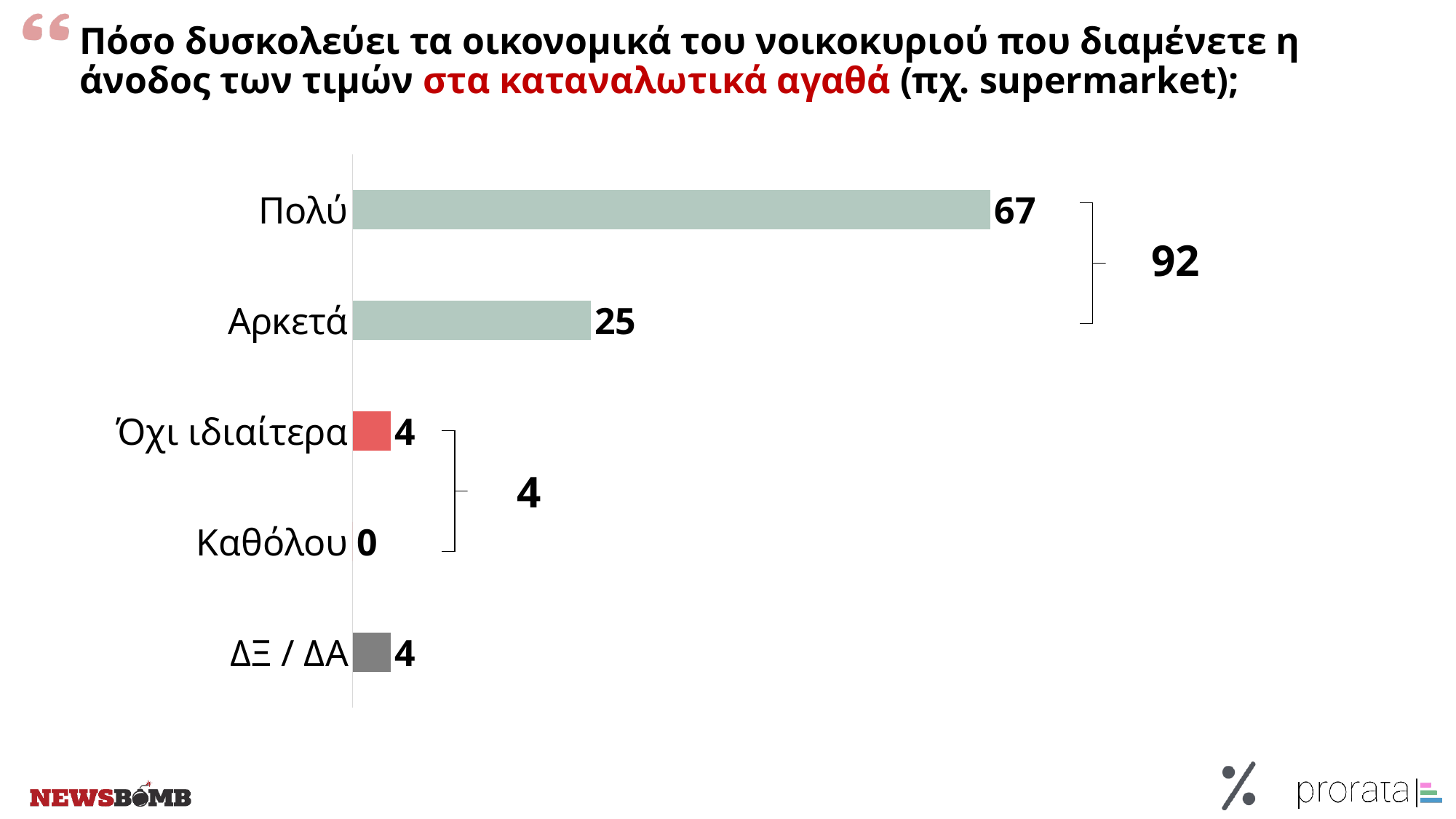
What combined value is shown by the bracket grouping Πολύ and Αρκετά? 92 What is the difference between the values for Πολύ and Αρκετά? 42 What is the value for Πολύ? 67 Which is larger, the value for Αρκετά or the value for Όχι ιδιαίτερα? Αρκετά How many categories are shown in the chart? 5 What kind of chart is shown on the slide? Bar chart What is the value for ΔΞ / ΔΑ? 4 What is the value for Καθόλου? 0 Which category has the highest value? Πολύ What is the value for Αρκετά? 25 What is the value for Όχι ιδιαίτερα? 4 Which category has the lowest value? Καθόλου